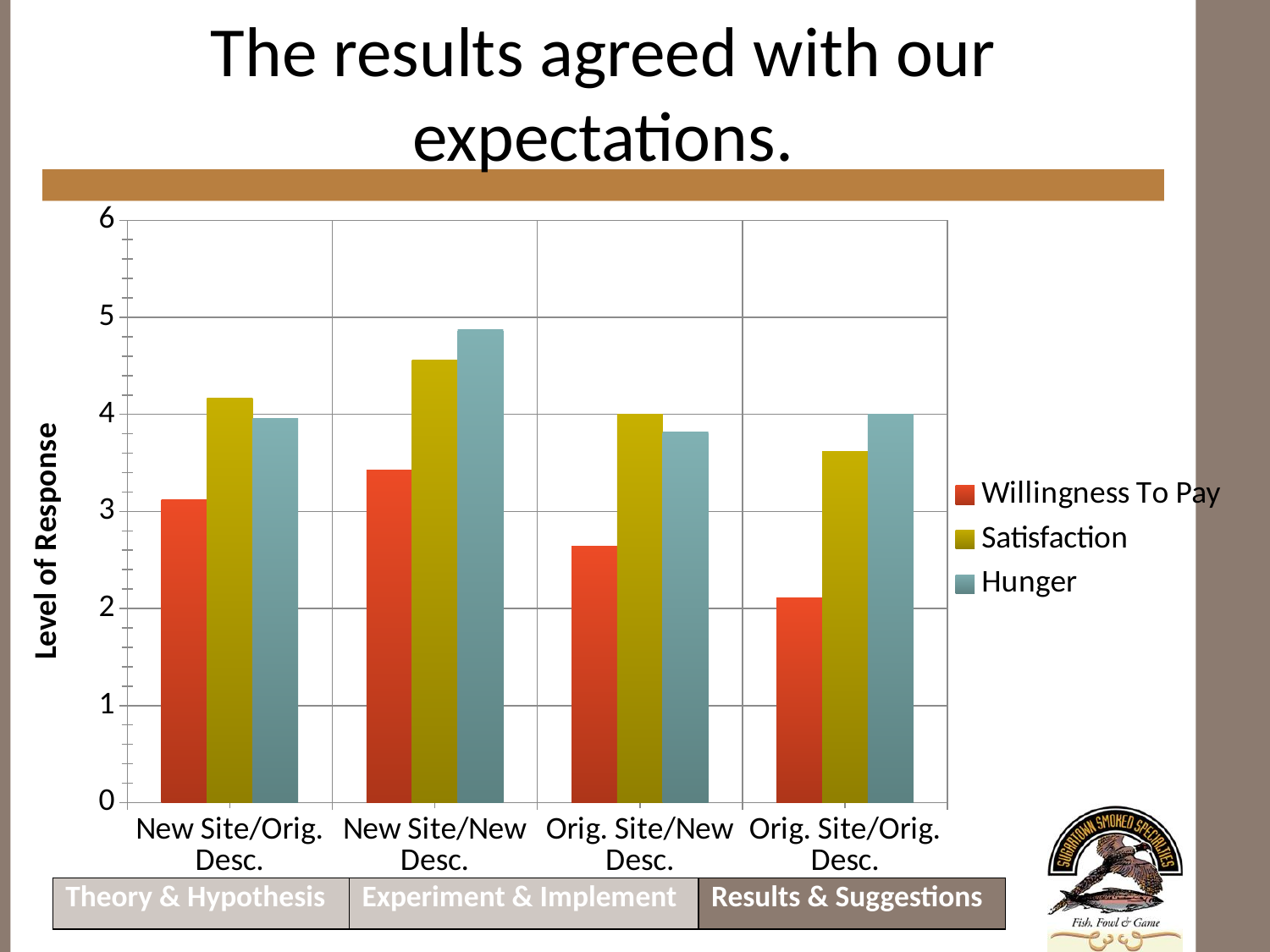
Which category has the highest Hunger value? New Site/New Desc. What is the title of the vertical axis? Level of Response For Orig. Site/Orig. Desc., which is larger: Hunger or Satisfaction? Hunger Is the Willingness To Pay value for Orig. Site/Orig. Desc. greater or less than 3? less Is the Hunger value for New Site/New Desc. greater or less than 4? greater Which category has the lowest Willingness To Pay value? Orig. Site/Orig. Desc. For New Site/New Desc., which is larger: Hunger or Satisfaction? Hunger Which category has the highest Willingness To Pay value? New Site/New Desc. How many series does the legend list? 3 Is the Satisfaction value for Orig. Site/Orig. Desc. greater or less than 4? less How many categories are shown on the x axis? 4 What kind of chart is shown on the slide? bar chart